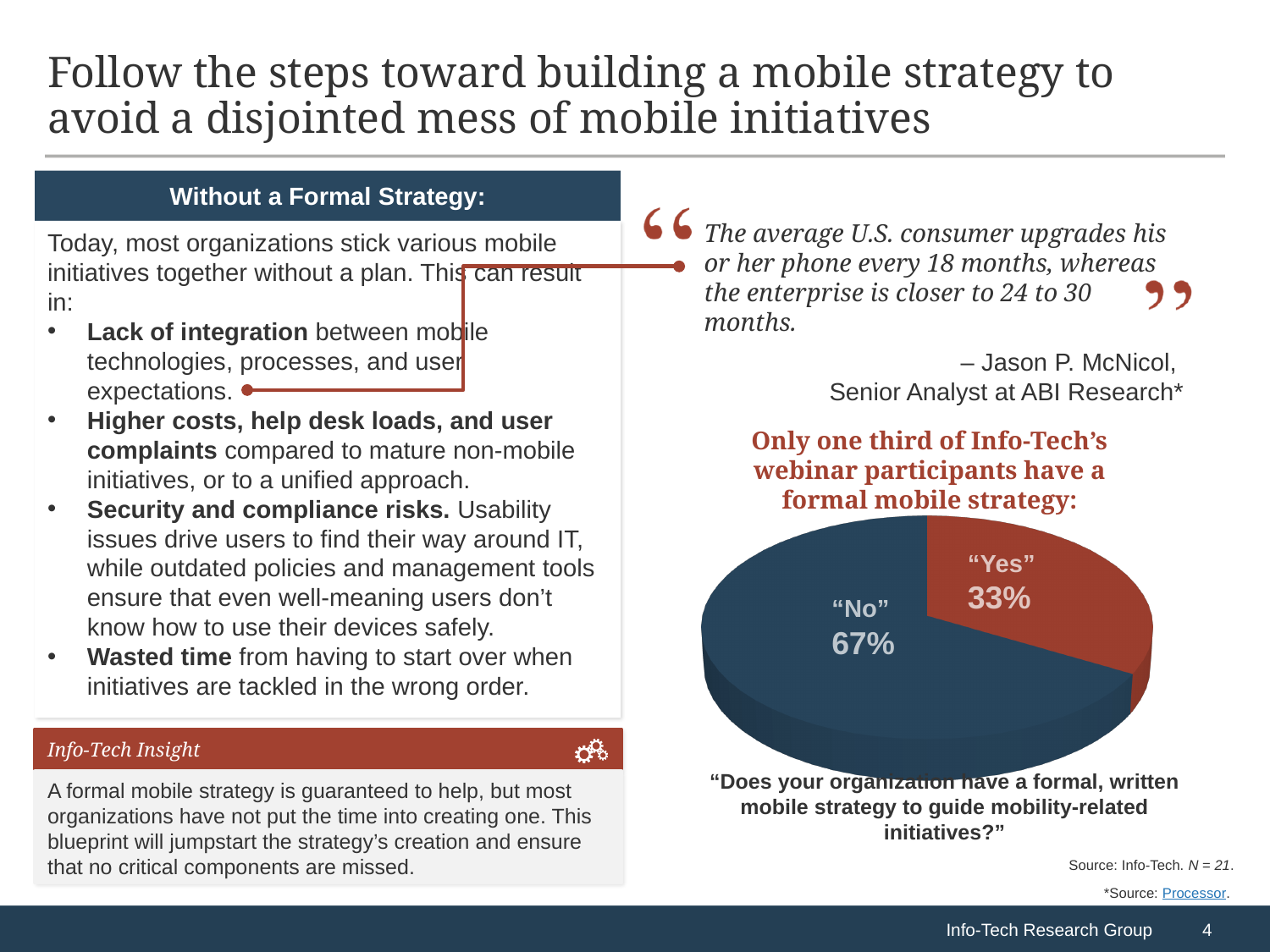
What is the difference in percentage points between the "No" and "Yes" slices? 34 Which is larger, the "Yes" slice or the "No" slice? "No" What percentage of webinar participants answered "Yes" to having a formal mobile strategy? 33% What share of the pie does the "Yes" slice represent? 33% Which slice of the pie chart is the smallest? "Yes" What colour is the "No" slice of the pie chart? dark blue What kind of chart is shown on the slide? pie chart Which slice of the pie chart is the largest? "No" What is the sample size (N) given in the source note for the pie chart? N = 21 What percentage of webinar participants answered "No"? 67% How many slices does the pie chart have? 2